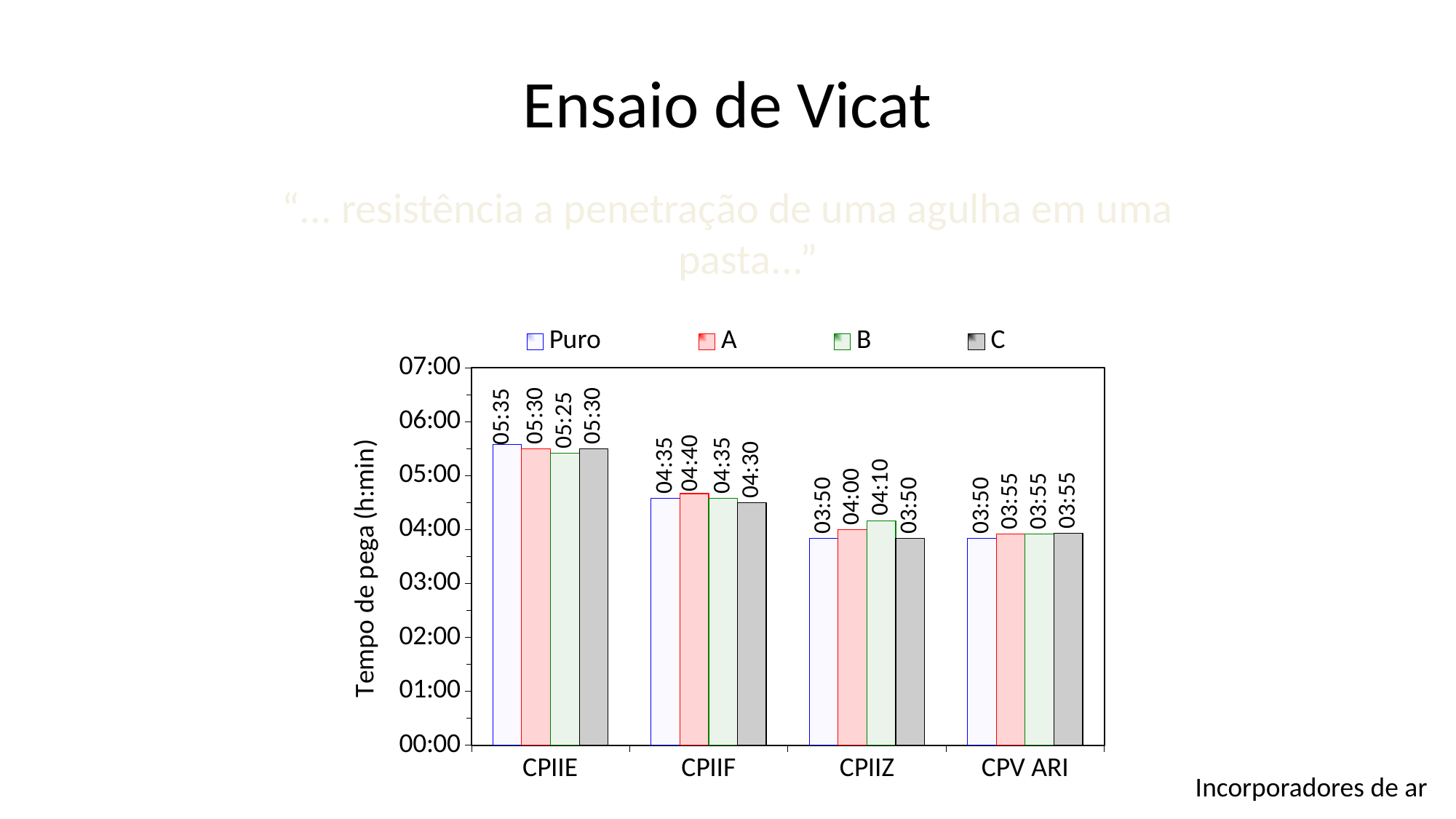
Do the values for series A rise or fall from CPIIE to CPV ARI along the x axis? fall How many categories are shown on the x axis? 4 Which series has the lowest value in the CPIIE category? B What is the value for Puro in the CPIIE category? 05:35 Is the value for Puro in the CPIIF category greater or less than 05:00? less What is the difference between the Puro value and the B value in the CPIIE category? 10 minutes What kind of chart is shown on the slide? bar chart In the CPIIZ category, which is larger: the value for A or the value for B? B Which category has the highest value for series A? CPIIE What is the value for series C in the CPIIF category? 04:30 How many series does the legend list? 4 What is the value for series B in the CPIIZ category? 04:10